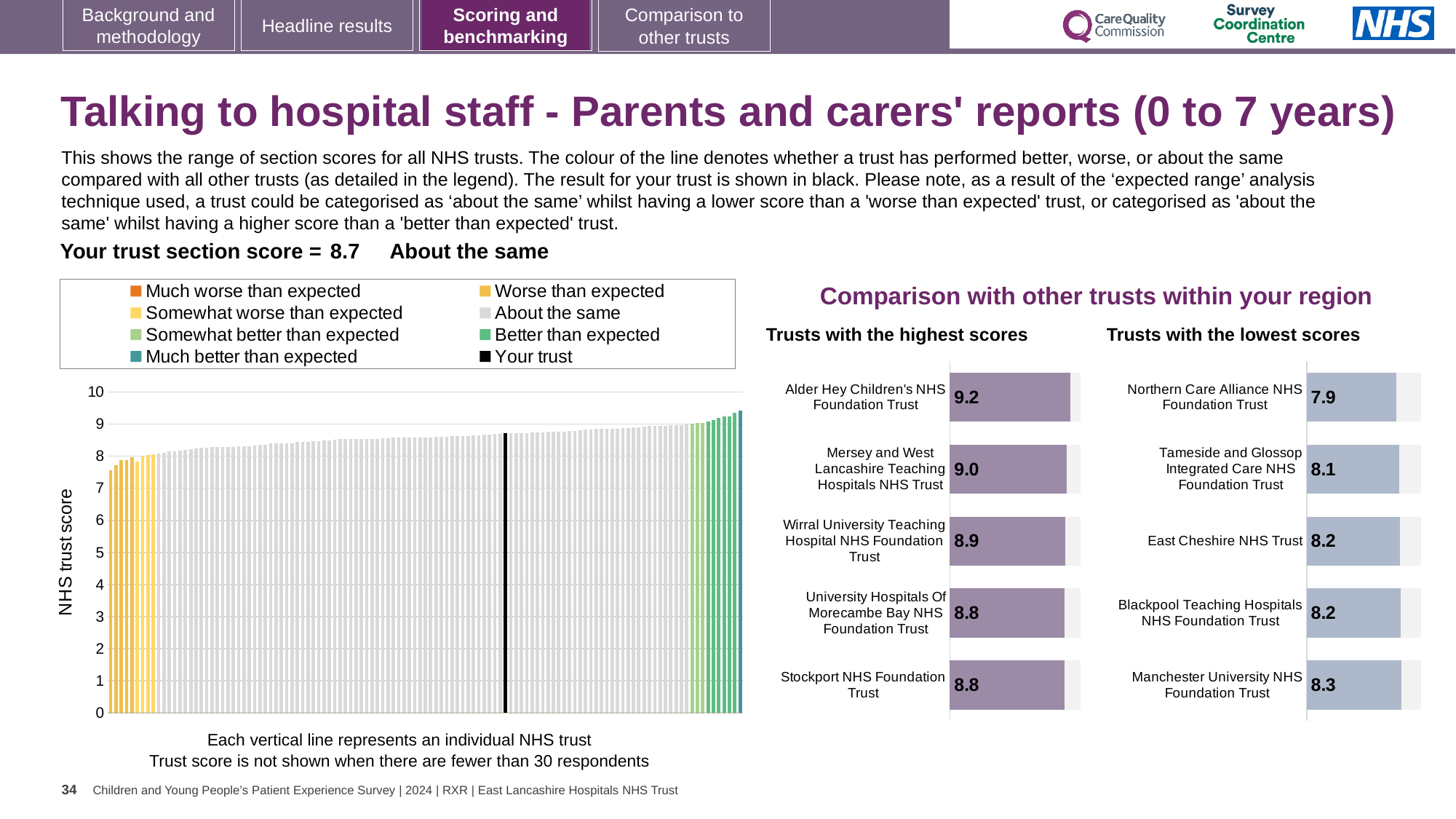
In the 'Trusts with the highest scores' chart, what is the difference between the scores of Alder Hey Children's NHS Foundation Trust and Stockport NHS Foundation Trust? 0.4 In the 'Trusts with the highest scores' chart, what is the score for Wirral University Teaching Hospital NHS Foundation Trust? 8.9 How many trusts are shown in the 'Trusts with the highest scores' chart? 5 What kind of chart is the large chart on the left showing all NHS trusts? Bar chart In the 'Trusts with the lowest scores' chart, which trust has the lowest score? Northern Care Alliance NHS Foundation Trust In the 'Trusts with the lowest scores' chart, what is the score for Northern Care Alliance NHS Foundation Trust? 7.9 What is the y-axis label of the large chart on the left? NHS trust score In the 'Trusts with the lowest scores' chart, what is the score for Manchester University NHS Foundation Trust? 8.3 In the 'Trusts with the highest scores' chart, what is the score for Alder Hey Children's NHS Foundation Trust? 9.2 In the 'Trusts with the highest scores' chart, which trust has the highest score? Alder Hey Children's NHS Foundation Trust In the large chart on the left, is the value for your trust (the black line) greater or less than 8? greater In the 'Trusts with the lowest scores' chart, which has the larger score: Tameside and Glossop Integrated Care NHS Foundation Trust or East Cheshire NHS Trust? East Cheshire NHS Trust